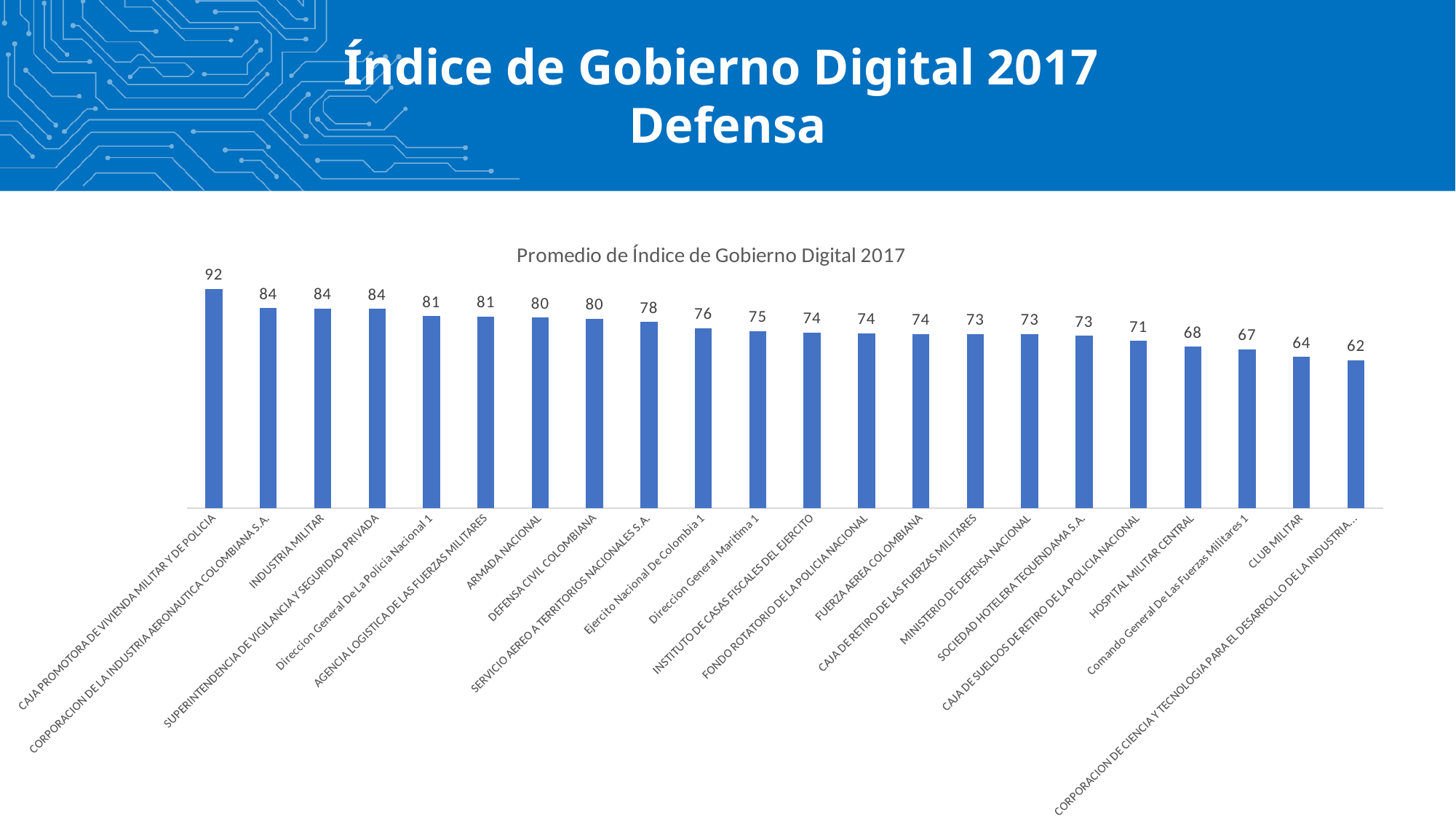
What is the value for MINISTERIO DE DEFENSA NACIONAL? 73 Which is larger, the value for Ejercito Nacional De Colombia 1 or the value for Comando General De Las Fuerzas Militares 1? Ejercito Nacional De Colombia 1 What is the difference between the values for CAJA PROMOTORA DE VIVIENDA MILITAR Y DE POLICIA and INDUSTRIA MILITAR? 8 What kind of chart is shown on the slide? Bar chart Which category has the highest value? CAJA PROMOTORA DE VIVIENDA MILITAR Y DE POLICIA What is the value for HOSPITAL MILITAR CENTRAL? 68 How many categories are shown in the chart? 22 What is the value for CLUB MILITAR? 64 What is the value for ARMADA NACIONAL? 80 What is the lowest value shown in the chart? 62 What is the title of the chart? Promedio de Índice de Gobierno Digital 2017 What is the difference between the values for FUERZA AEREA COLOMBIANA and CLUB MILITAR? 10